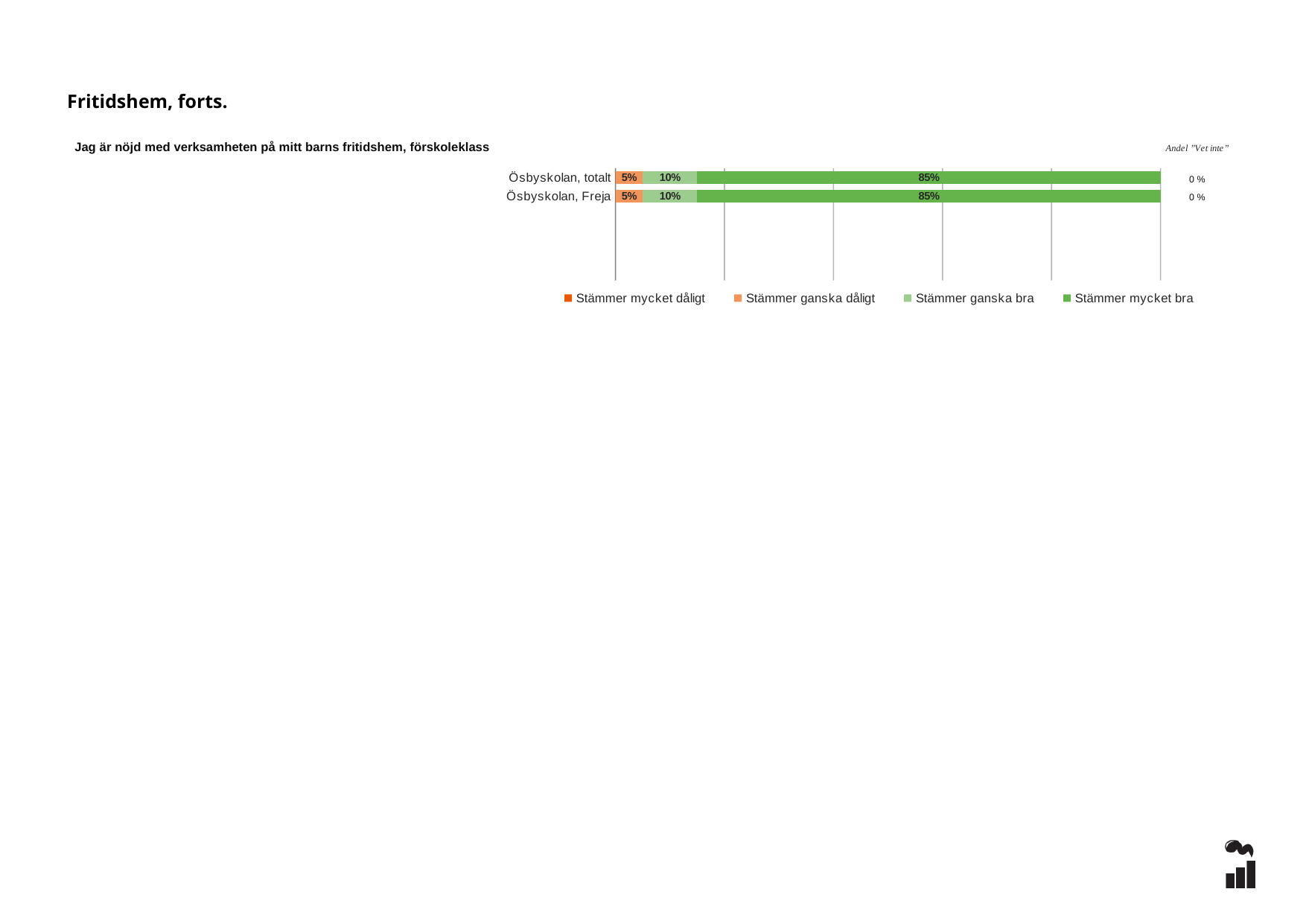
Which response category has the largest share for Ösbyskolan, Freja? Stämmer mycket bra How many categories (rows) does the chart show? 2 What is the value of "Stämmer ganska dåligt" for Ösbyskolan, totalt? 5% What is the difference between "Stämmer mycket bra" and "Stämmer ganska bra" for Ösbyskolan, totalt? 75% How many series does the legend list? 4 What kind of chart is shown on the slide? Stacked bar chart What is the value of "Stämmer mycket bra" for Ösbyskolan, totalt? 85% Which is larger for Ösbyskolan, Freja: "Stämmer ganska dåligt" or "Stämmer ganska bra"? Stämmer ganska bra What is the combined share of "Stämmer ganska bra" and "Stämmer mycket bra" for Ösbyskolan, Freja? 95% What is the title of the chart? Jag är nöjd med verksamheten på mitt barns fritidshem, förskoleklass What is the "Andel 'Vet inte'" value shown for Ösbyskolan, totalt? 0 % What is the value of "Stämmer ganska bra" for Ösbyskolan, Freja? 10%